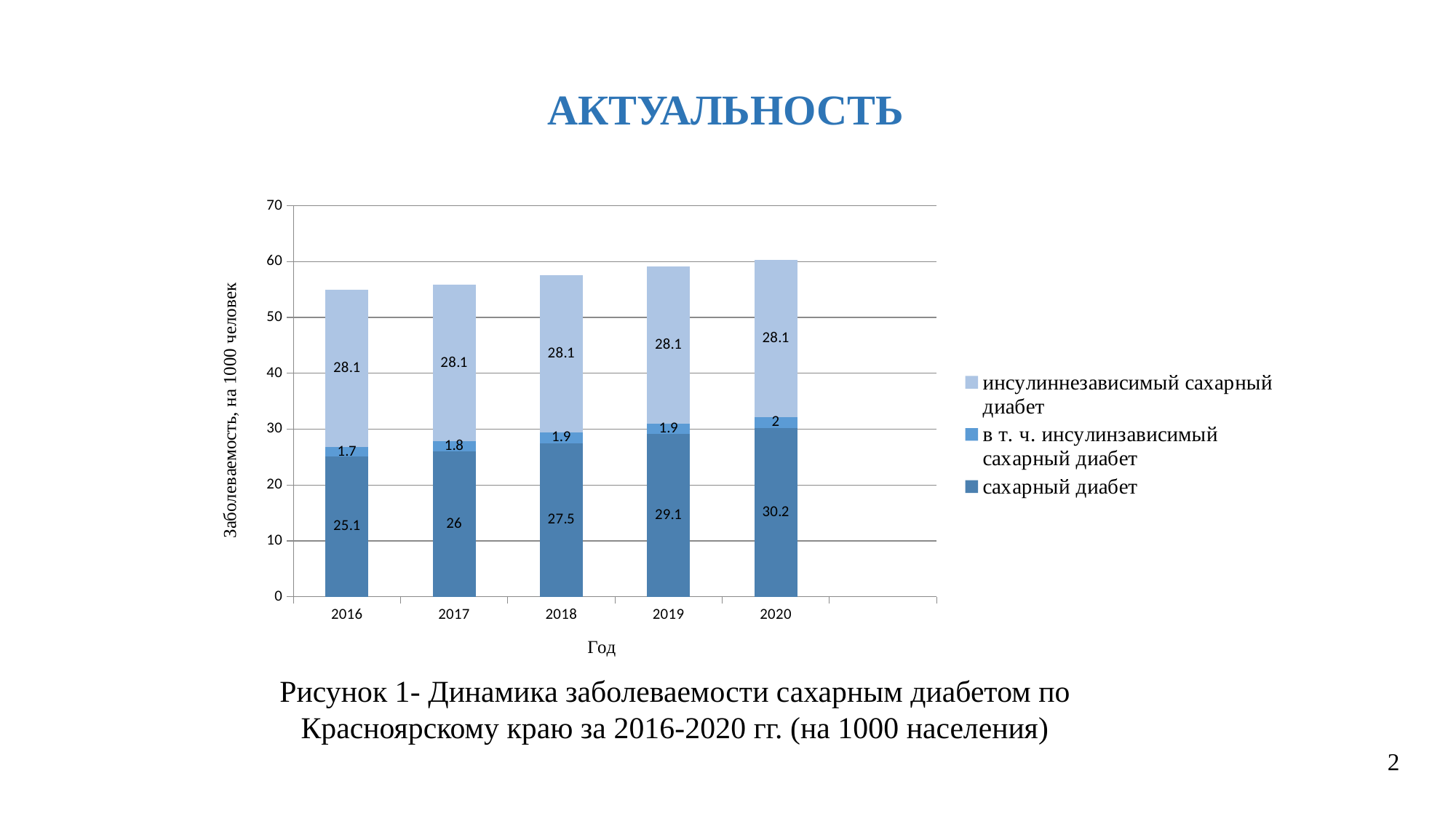
What is the total of the stacked bar for 2020? 60.3 How many years are shown on the x axis? 5 What is the value for "сахарный диабет" in 2020? 30.2 How many series does the legend list? 3 What type of chart is shown on the slide? stacked bar chart What is the difference between the "сахарный диабет" values for 2020 and 2016? 5.1 Which is larger: the "сахарный диабет" value for 2019 or for 2017? 2019 In which year is the value for "сахарный диабет" the highest? 2020 In which year is the value for "сахарный диабет" the lowest? 2016 What is the value for "инсулиннезависимый сахарный диабет" in 2018? 28.1 What is the value for "в т. ч. инсулинзависимый сахарный диабет" in 2016? 1.7 Does the value for "сахарный диабет" rise or fall from 2016 to 2020? rise